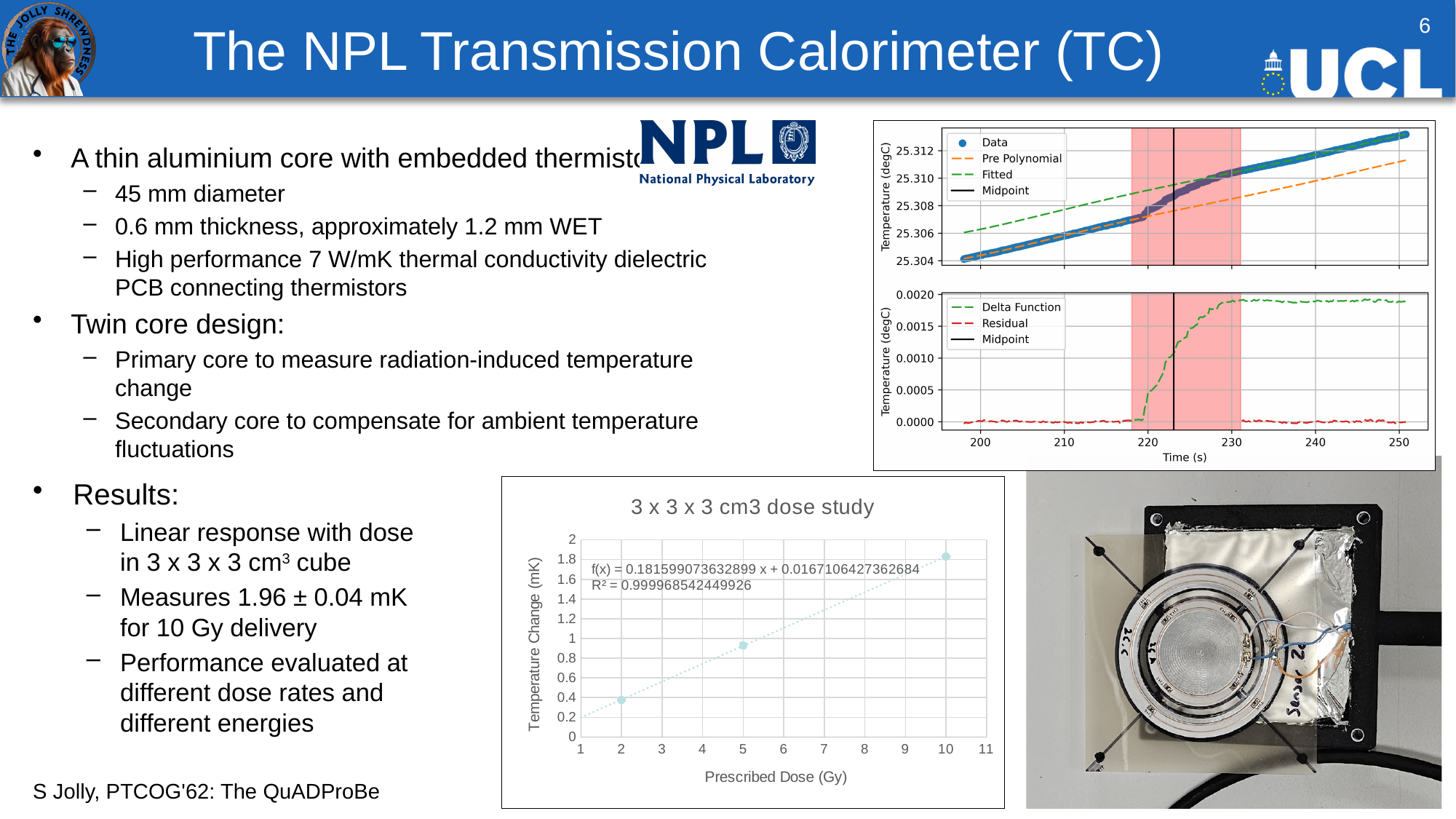
How many series does the legend of the lower temperature-vs-time chart in the top right list? 3 What kind of chart is the '3 x 3 x 3 cm3 dose study' chart? scatter chart In the '3 x 3 x 3 cm3 dose study' chart, is the temperature change at 5 Gy greater or less than 0.8 mK? greater What is the x-axis title of the '3 x 3 x 3 cm3 dose study' chart? Prescribed Dose (Gy) How many series does the legend of the upper temperature-vs-time chart in the top right list? 4 In the '3 x 3 x 3 cm3 dose study' chart, which prescribed dose gives the highest temperature change? 10 Gy In the '3 x 3 x 3 cm3 dose study' chart, is the temperature change at 2 Gy greater or less than 0.6 mK? less In the '3 x 3 x 3 cm3 dose study' chart, which prescribed dose gives the lowest temperature change? 2 Gy In the '3 x 3 x 3 cm3 dose study' chart, is the temperature change at 10 Gy greater or less than 1.6 mK? greater How many data points are plotted in the '3 x 3 x 3 cm3 dose study' chart? 3 What R² value is printed on the '3 x 3 x 3 cm3 dose study' chart? 0.999968542449926 In the '3 x 3 x 3 cm3 dose study' chart, does the temperature change rise or fall as prescribed dose increases? rise